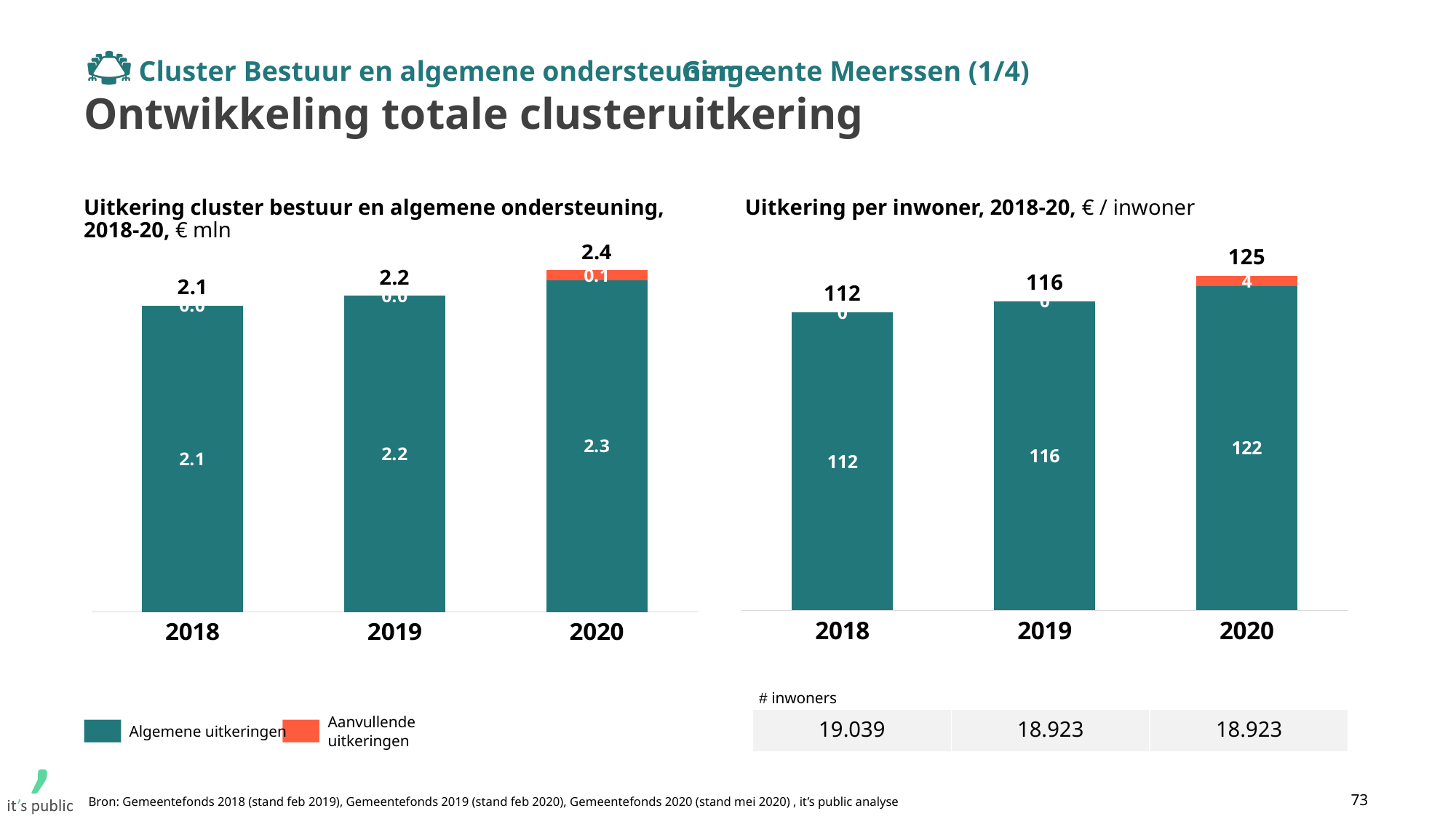
In the left chart (Uitkering cluster bestuur en algemene ondersteuning), what is the value of Algemene uitkeringen in 2019? 2.2 In the right chart (Uitkering per inwoner), what is the difference between the total values for 2019 and 2018? 4 In the right chart (Uitkering per inwoner), which year has the highest total value? 2020 In the left chart (Uitkering cluster bestuur en algemene ondersteuning), do the total values rise or fall from 2018 to 2020? rise What kind of chart is the right chart (Uitkering per inwoner)? stacked bar chart In the right chart (Uitkering per inwoner), what is the value of Algemene uitkeringen in 2020? 122 In the left chart (Uitkering cluster bestuur en algemene ondersteuning), which year has the lowest total value? 2018 In the right chart (Uitkering per inwoner), what is the total value for 2018? 112 In the left chart (Uitkering cluster bestuur en algemene ondersteuning), what is the total value for 2020? 2.4 In the left chart (Uitkering cluster bestuur en algemene ondersteuning), what is the value of Aanvullende uitkeringen in 2020? 0.1 How many series does the legend list for the left chart (Uitkering cluster bestuur en algemene ondersteuning)? 2 How many years are shown on the x axis of the right chart (Uitkering per inwoner)? 3